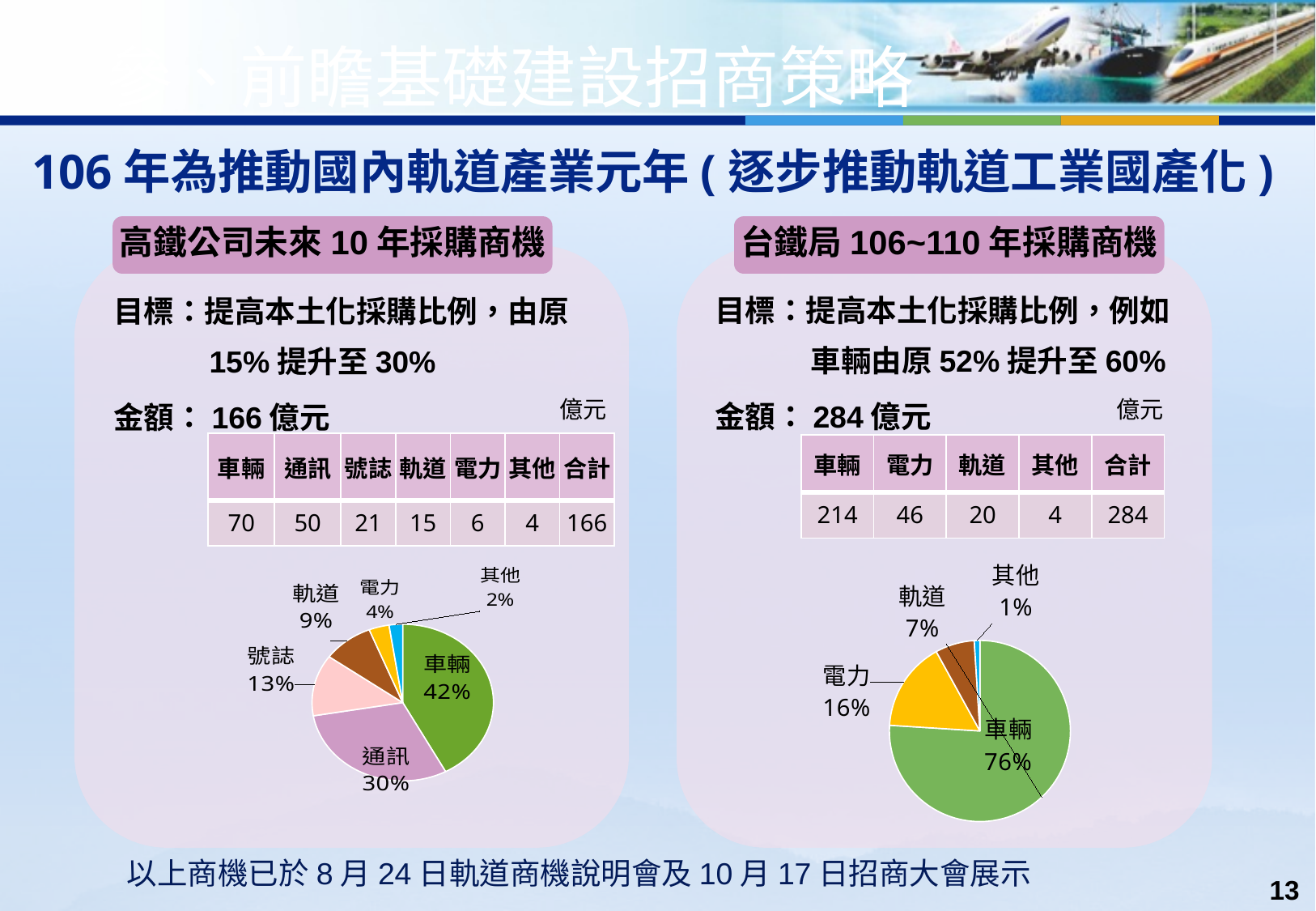
In the left pie chart (高鐵公司未來10年採購商機), what share does 通訊 have? 30% In the left pie chart (高鐵公司未來10年採購商機), what share does 車輛 have? 42% What type of chart is shown on the left side of the slide (高鐵公司未來10年採購商機)? pie chart In the left pie chart (高鐵公司未來10年採購商機), which category has the smallest slice? 其他 In the left pie chart (高鐵公司未來10年採購商機), what is the difference in percentage points between 號誌 and 軌道? 4 In the right pie chart (台鐵局106~110年採購商機), what share does 電力 have? 16% In the left pie chart (高鐵公司未來10年採購商機), which is larger, 電力 or 其他? 電力 In the right pie chart (台鐵局106~110年採購商機), what is the difference in percentage points between 電力 and 軌道? 9 In the right pie chart (台鐵局106~110年採購商機), how many slices are there? 4 In the left pie chart (高鐵公司未來10年採購商機), how many slices are there? 6 In the right pie chart (台鐵局106~110年採購商機), which category has the largest slice? 車輛